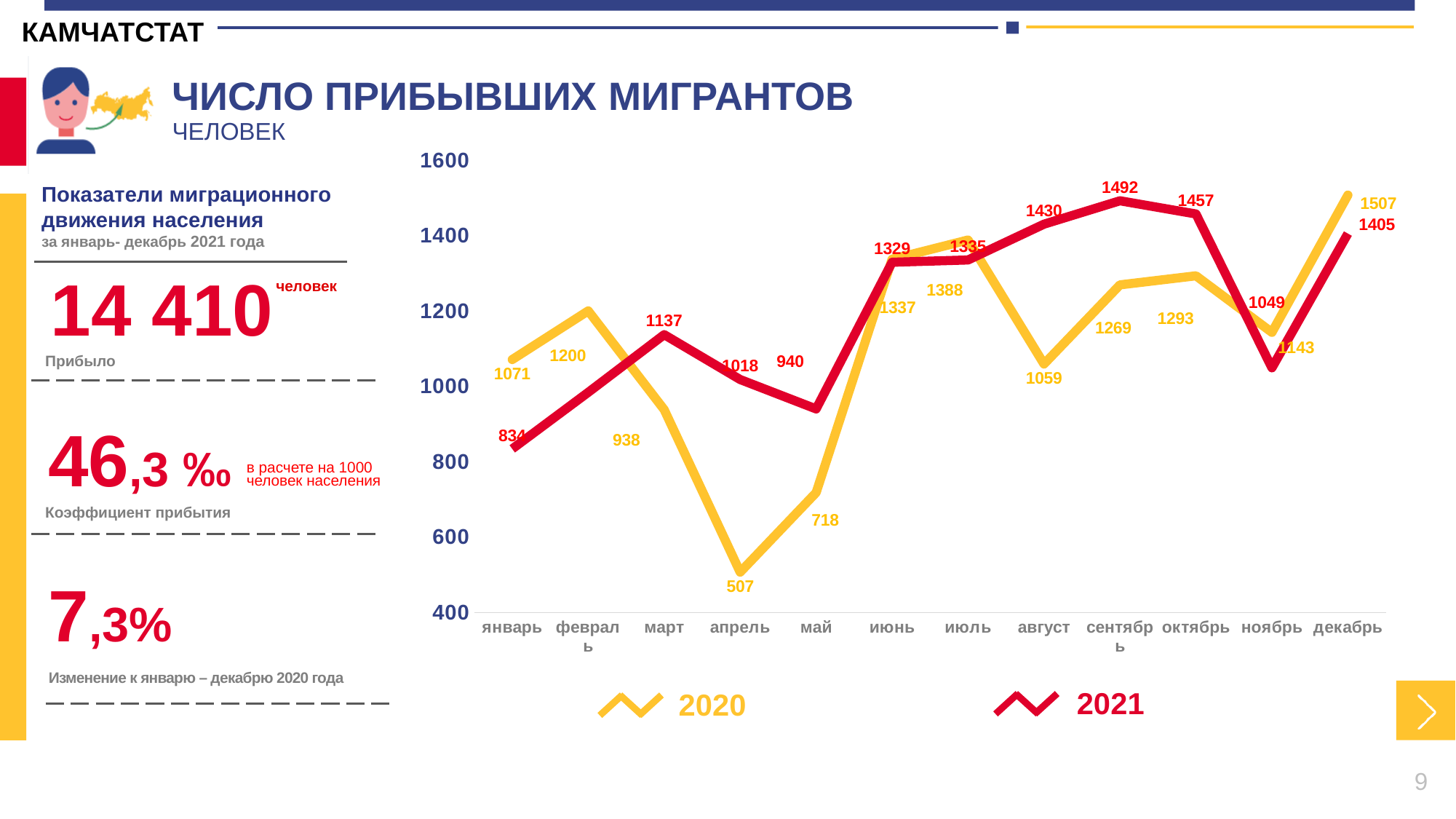
What is the difference between the 2020 and 2021 values for декабрь? 102 Which month has the highest value in the 2020 series? декабрь What is the value for сентябрь in the 2021 series? 1492 How many series does the legend list? 2 Which month has the lowest value in the 2020 series? апрель Which month has the highest value in the 2021 series? сентябрь What kind of chart is shown on the slide? line chart Which series has the larger value for август, 2020 or 2021? 2021 What is the value for апрель in the 2020 series? 507 Is the value for февраль in the 2021 series greater or less than 1200? less How many months are plotted along the x axis? 12 What is the value for январь in the 2021 series? 834